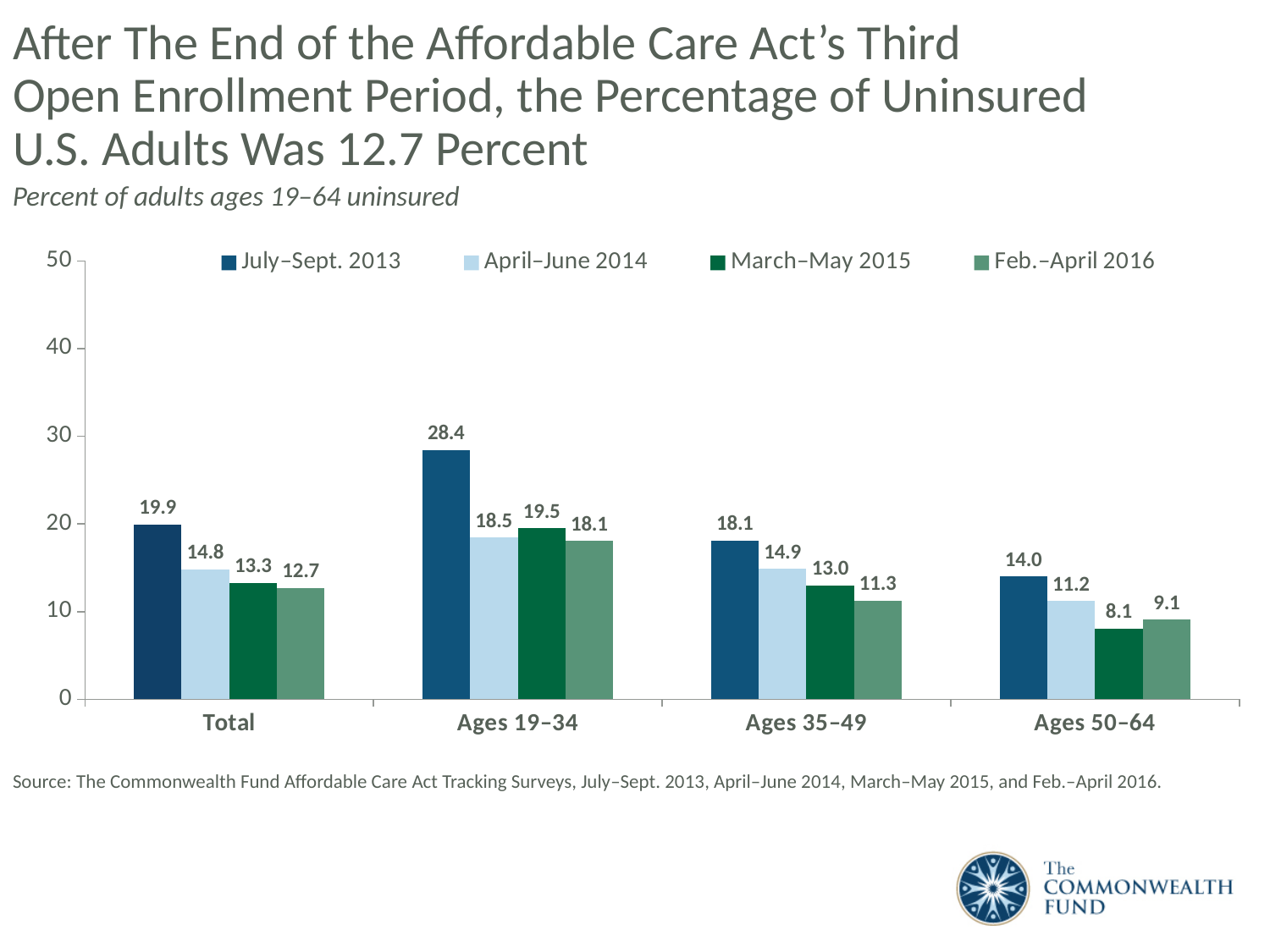
What is the value for Ages 19–34 in the July–Sept. 2013 series? 28.4 What kind of chart is shown on the slide? Bar chart What is the value for Ages 50–64 in the March–May 2015 series? 8.1 How many categories are shown on the x axis? 4 How many series does the legend list? 4 Which is larger for Ages 35–49: the April–June 2014 value or the March–May 2015 value? April–June 2014 Which age group has the highest value in the July–Sept. 2013 series? Ages 19–34 What is the value for Total in the Feb.–April 2016 series? 12.7 Which category has the lowest value in the Feb.–April 2016 series? Ages 50–64 What is the difference between the July–Sept. 2013 and Feb.–April 2016 values for Total? 7.2 What is the subtitle describing the measure plotted in the chart? Percent of adults ages 19–64 uninsured Is the value for Ages 19–34 in the July–Sept. 2013 series greater or less than 20? greater